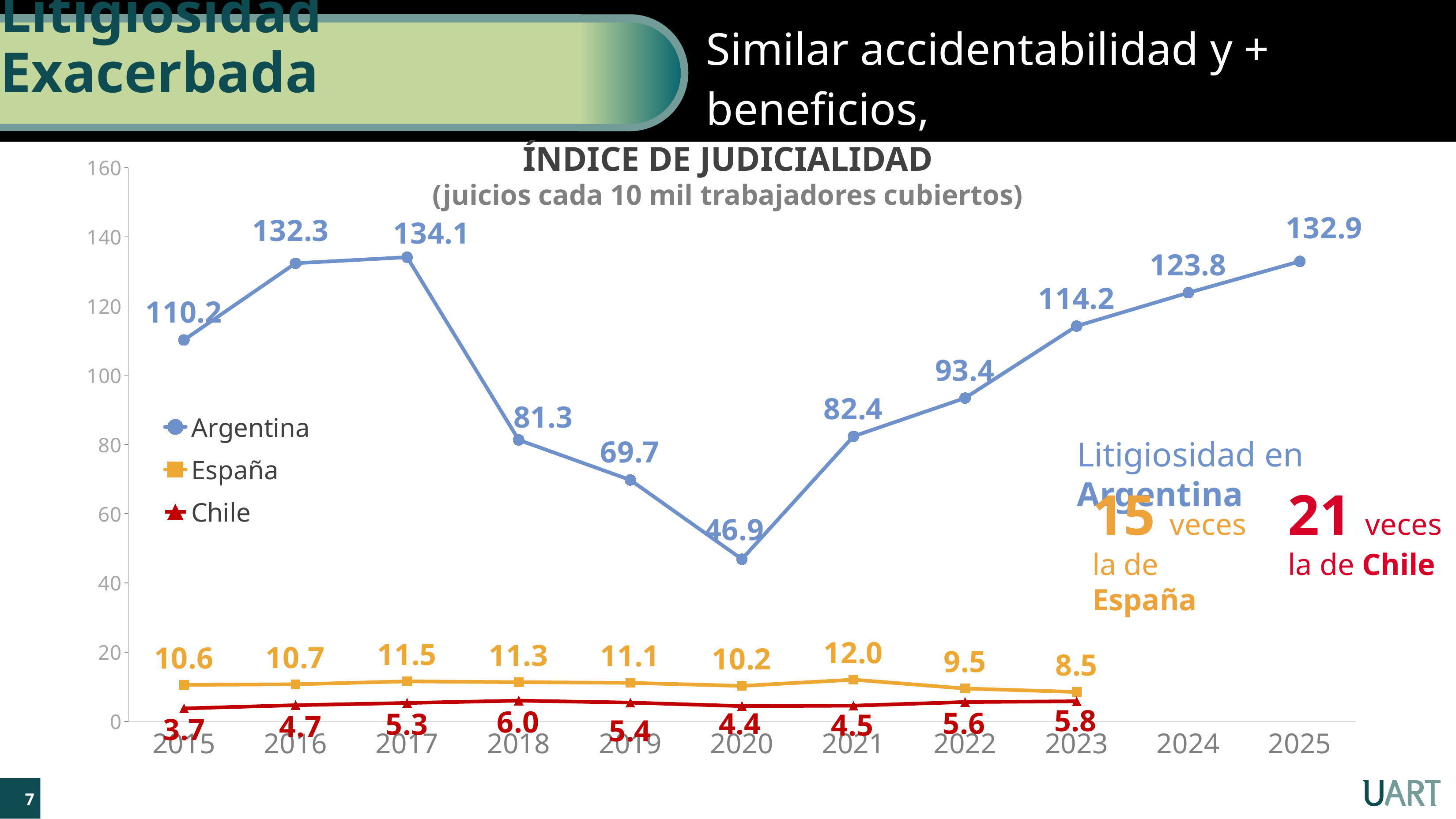
Does the Argentina series rise or fall from 2020 to 2025? rise What is the value for Argentina in 2020? 46.9 In which year does Chile have its lowest value? 2015 How many years are shown on the x axis? 11 What is the value for España in 2021? 12.0 What is the value for Chile in 2018? 6.0 What is the difference between Argentina's value in 2017 and its value in 2020? 87.2 What kind of chart is shown on the slide? line chart Is the value for Argentina in 2024 greater or less than 120? greater Which is larger, España's value in 2023 or Chile's value in 2023? España's value in 2023 How many series does the legend list? 3 In which year does Argentina reach its highest value? 2017